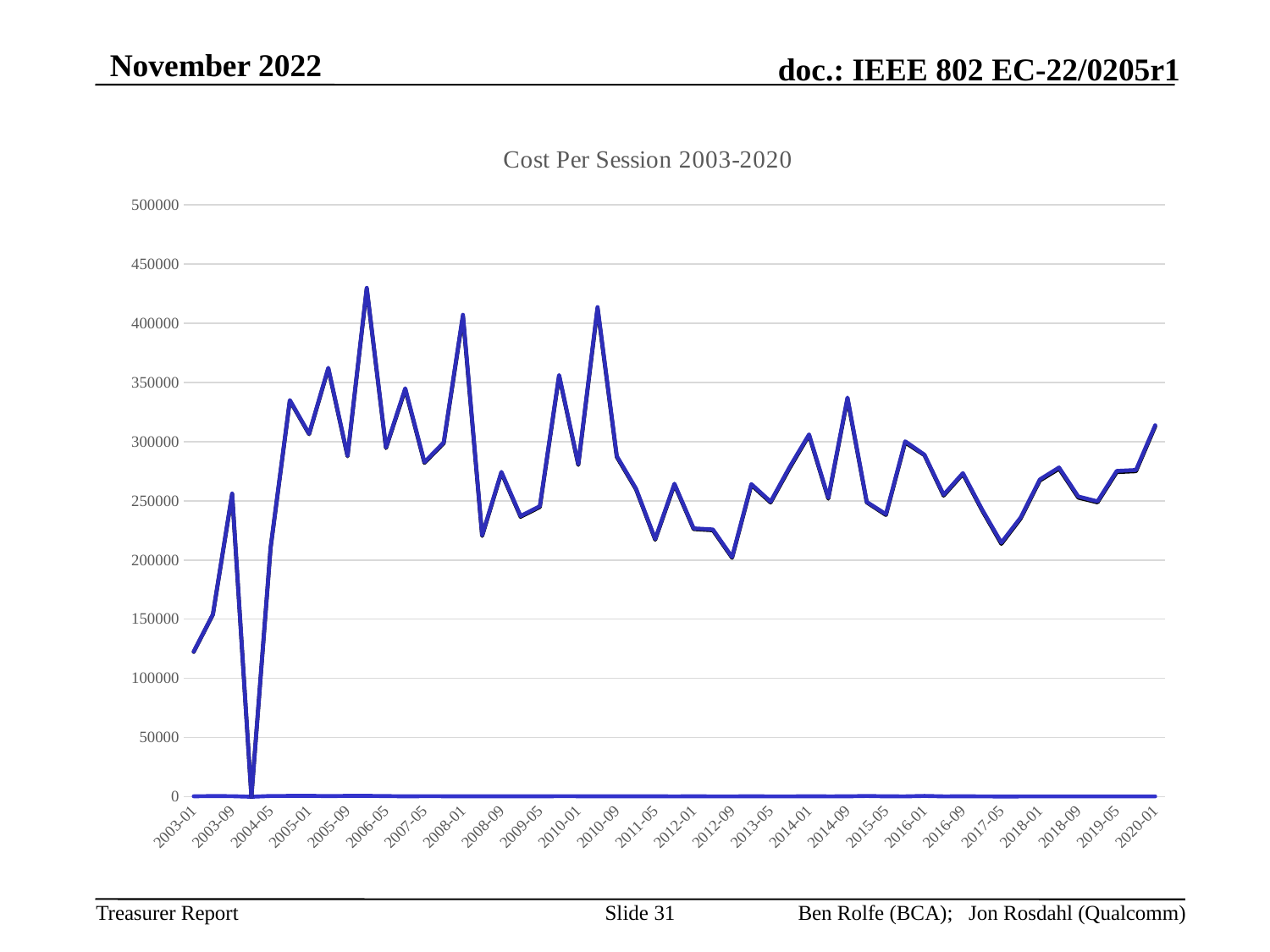
Is the value for 2003-01 greater or less than 100000? greater Is the value for 2003-01 greater or less than 150000? less What is the title of the chart? Cost Per Session 2003-2020 Does the line rise or fall between 2003-01 and 2003-09? rise Is the highest point on the line greater or less than 400000? greater Which is larger, the value for 2003-01 or the value for 2020-01? 2020-01 What kind of chart is shown on the slide? line chart What is the highest value shown on the vertical axis? 500000